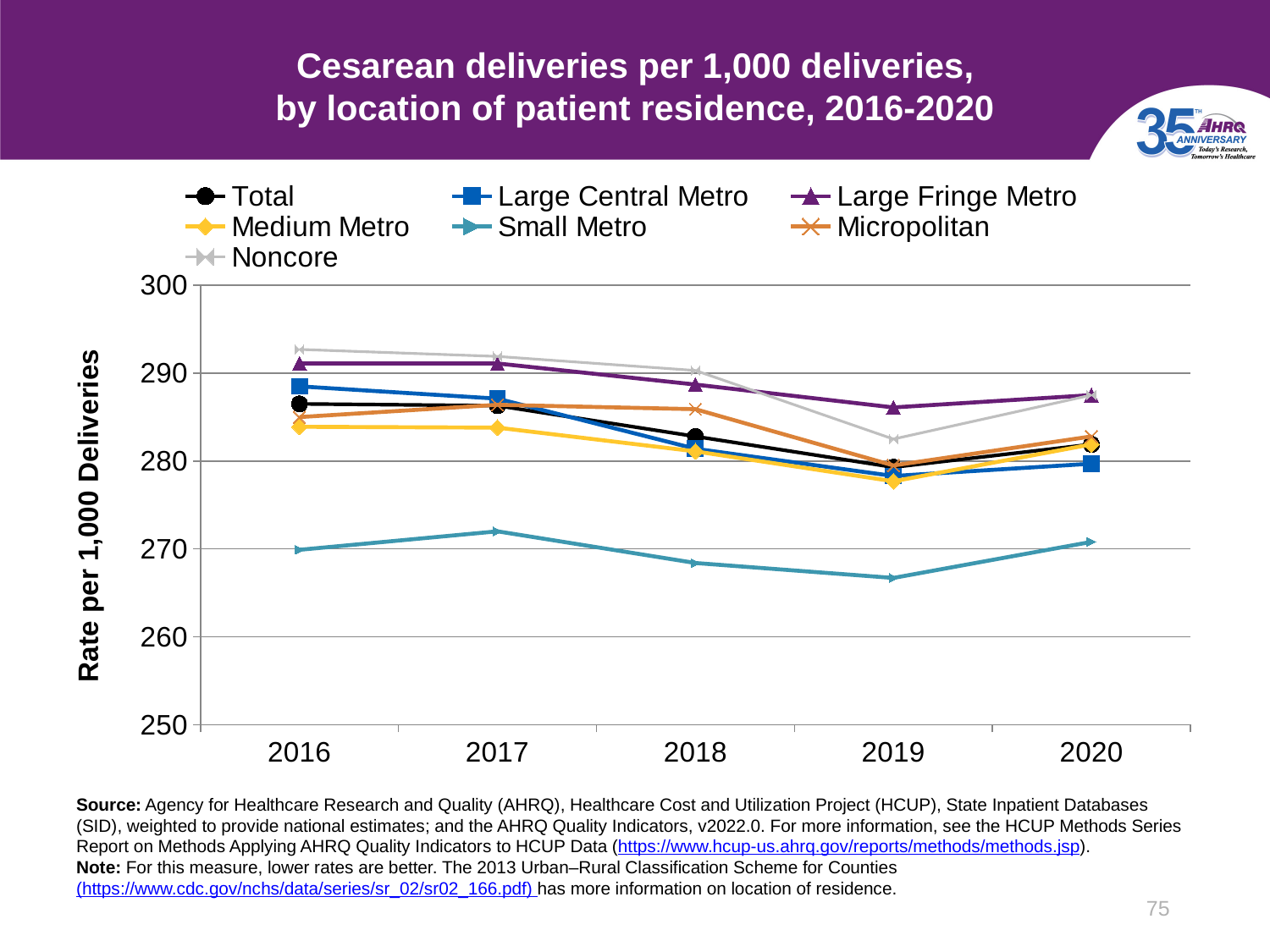
Which location of residence has the lowest cesarean delivery rate in 2016? Small Metro Which location of residence has the highest cesarean delivery rate in 2019? Large Fringe Metro How many series does the legend list? 7 In 2020, which is larger: the rate for Large Fringe Metro or for Small Metro? Large Fringe Metro What is the title of the y axis? Rate per 1,000 Deliveries In 2019, which is larger: the rate for Noncore or for Large Fringe Metro? Large Fringe Metro What kind of chart is shown on the slide? Line chart Does the Total rate rise or fall from 2016 to 2019? Fall How many years are plotted along the x axis? 5 Is the value for Noncore in 2016 greater or less than 290? greater Is the value for Medium Metro in 2019 greater or less than 280? less Is the value for Small Metro in 2019 greater or less than 270? less